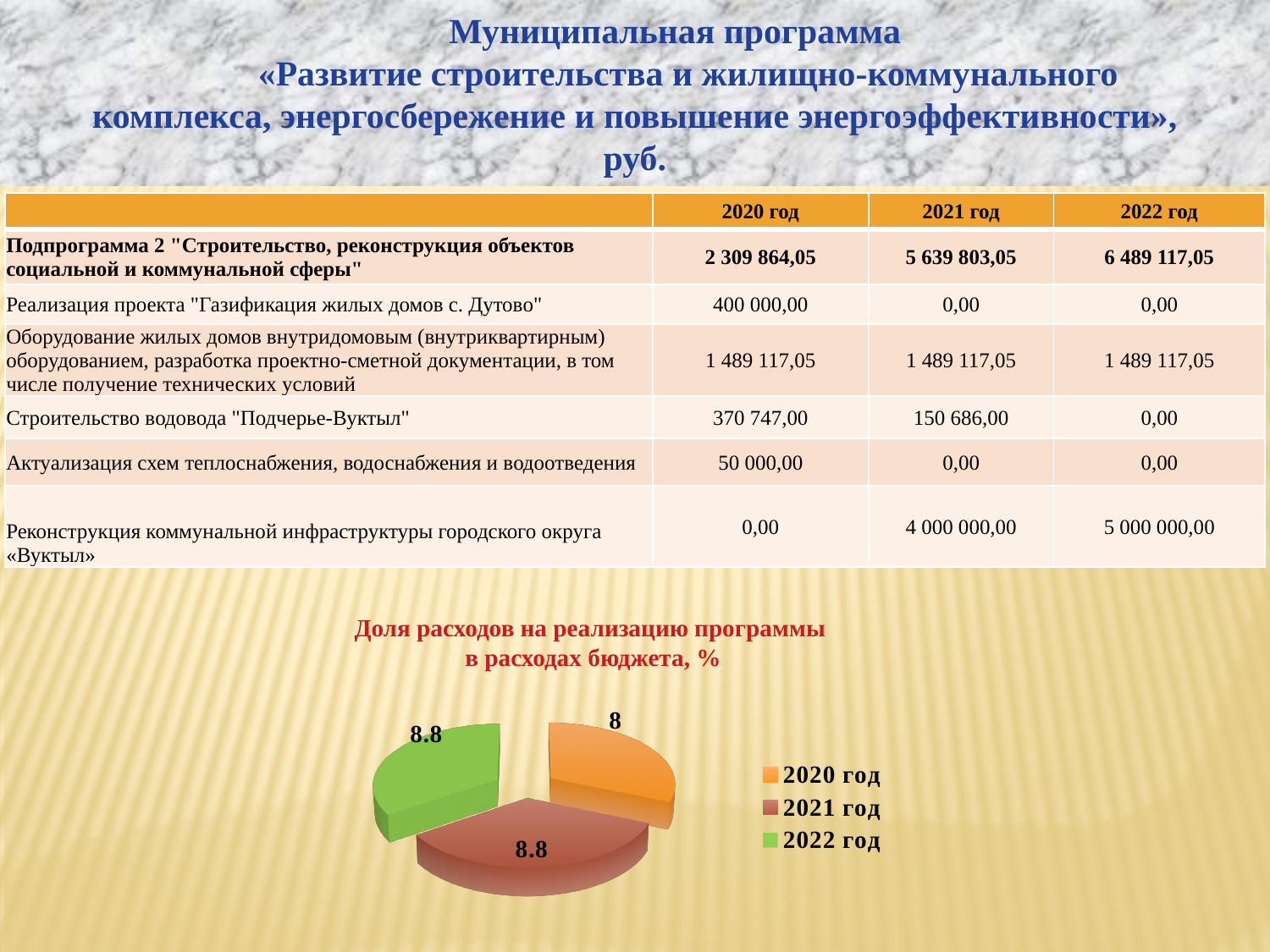
In the pie chart, what is the difference between the value for 2021 год and the value for 2020 год? 0.8 In the pie chart, are the values for 2021 год and 2022 год equal? yes How many entries does the legend of the pie chart list? 3 How many slices does the pie chart have? 3 Which year has the smallest slice in the pie chart? 2020 год In the pie chart, what is the value for 2020 год? 8 What is the title of the pie chart? Доля расходов на реализацию программы в расходах бюджета, % In the pie chart, what is the value for 2021 год? 8.8 In the pie chart, what is the value for 2022 год? 8.8 What colour is the slice for 2022 год in the pie chart? green In the pie chart, which is larger: the value for 2020 год or for 2021 год? 2021 год What type of chart is shown on the slide? pie chart